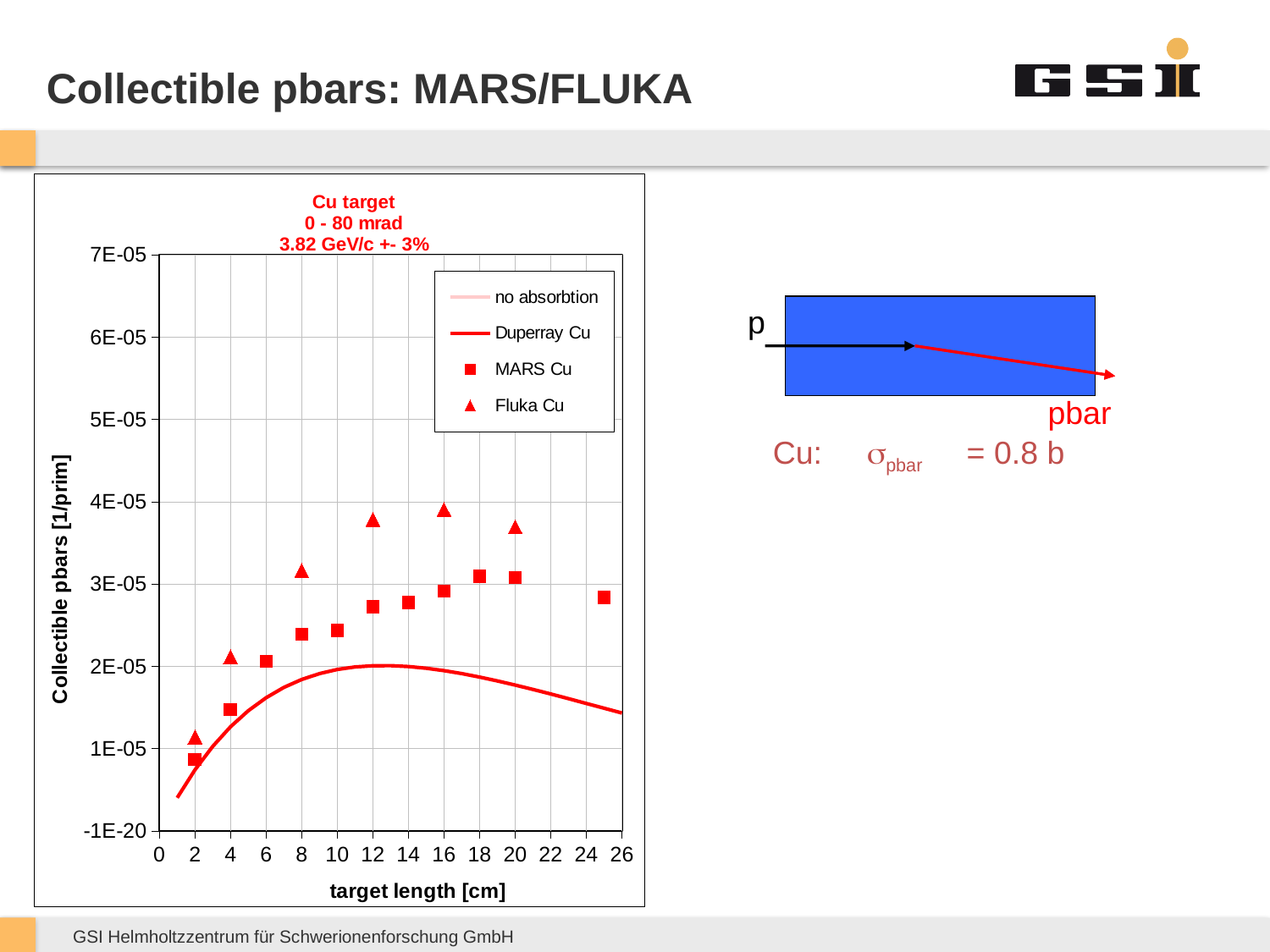
Does the Duperray Cu curve reach above 3E-05 anywhere on the chart? no How many MARS Cu data points are plotted? 11 How many series does the chart legend list? 4 Is the Fluka Cu value at a target length of 16 cm greater or less than 3E-05? greater How many Fluka Cu data points are plotted? 6 At a target length of 16 cm, which is larger: the Fluka Cu value or the MARS Cu value? Fluka Cu At which target length is the MARS Cu value lowest? 2 cm Is the MARS Cu value at a target length of 12 cm greater or less than 3E-05? less What kind of chart is shown on the slide? scatter chart What is the label of the y axis? Collectible pbars [1/prim] How does the Duperray Cu curve behave as target length increases from 0 to 26 cm? rises, then falls after about 12 cm